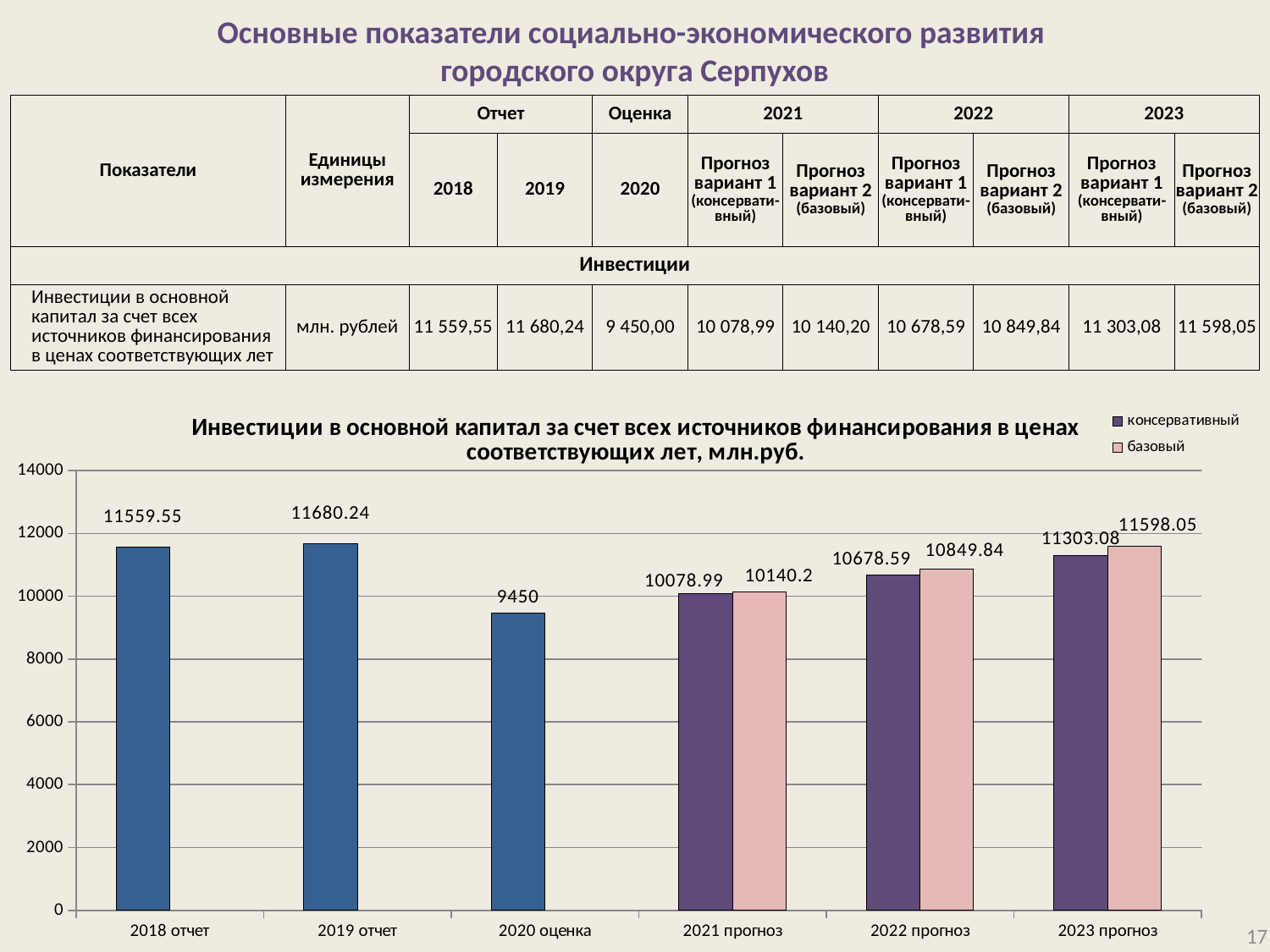
How many categories are shown on the x axis of the chart? 6 What is the value for 2019 отчет in the chart? 11680.24 Which is larger in the chart: the value for 2018 отчет or the базовый value for 2023 прогноз? 2023 прогноз базовый How many series does the chart legend list? 2 Is the value for 2020 оценка greater or less than 10000? less What is the базовый value for 2022 прогноз in the chart? 10849.84 What is the value for 2020 оценка in the chart? 9450 What is the консервативный value for 2023 прогноз in the chart? 11303.08 What type of chart is shown on the slide? bar chart Which category has the highest value in the chart? 2019 отчет What is the difference between the базовый and консервативный values for 2021 прогноз? 61.21 Which category has the lowest value in the chart? 2020 оценка